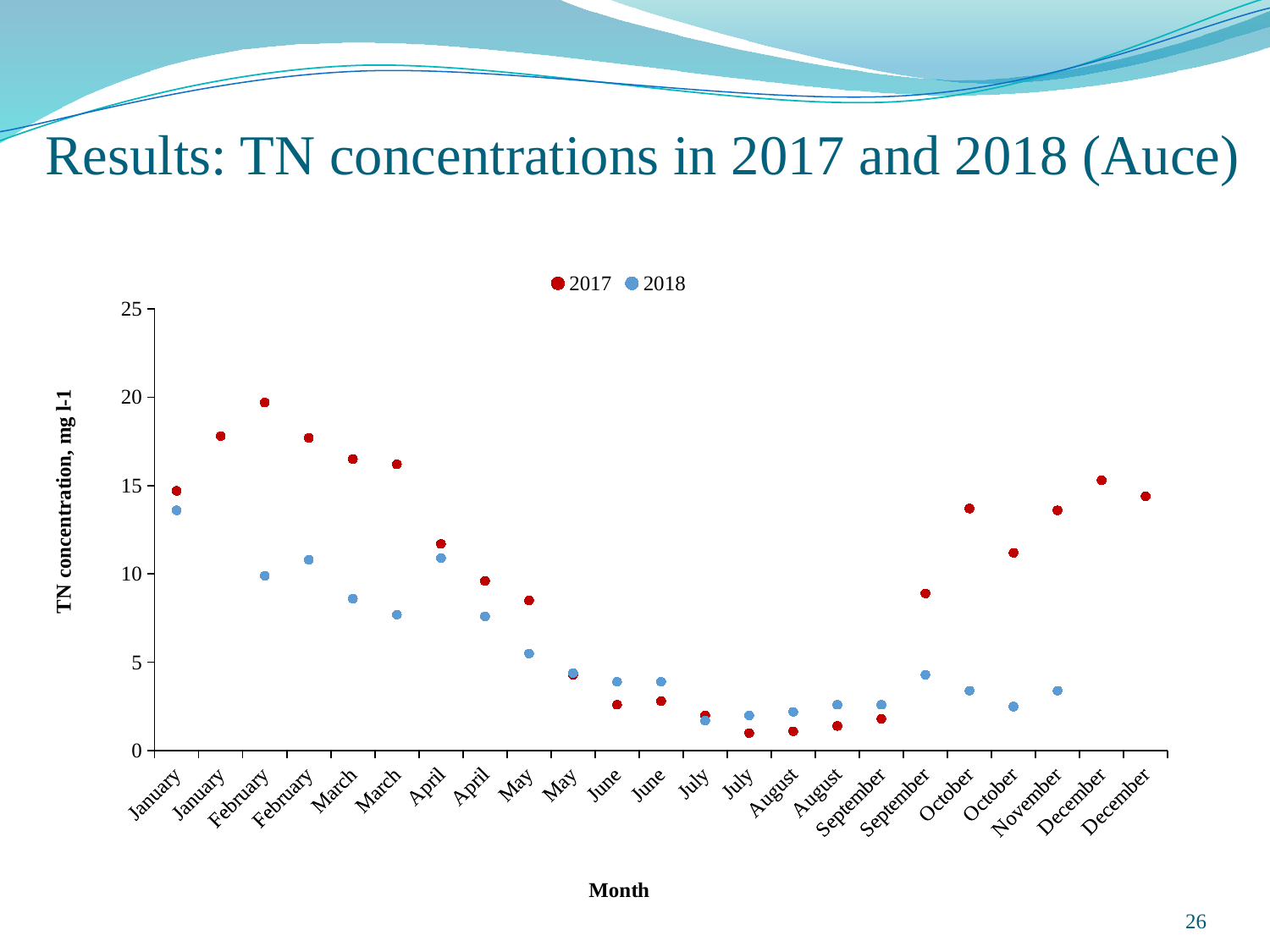
Is the 2018 value for the first October point greater or less than 5? less At which month label does the 2017 series reach its highest value? February (first) At which month label does the 2018 series reach its highest value? January (first) Is the 2017 value for the second July point greater or less than 5? less How many series does the legend list? 2 Do the 2017 values rise or fall from the first February point to the second July point? fall What kind of chart is shown on the slide? scatter chart What is the title of the vertical axis? TN concentration, mg l-1 Is the 2017 value for the first February point greater or less than 15? greater At the first January point, which series has the larger value, 2017 or 2018? 2017 Which series is shown with red markers? 2017